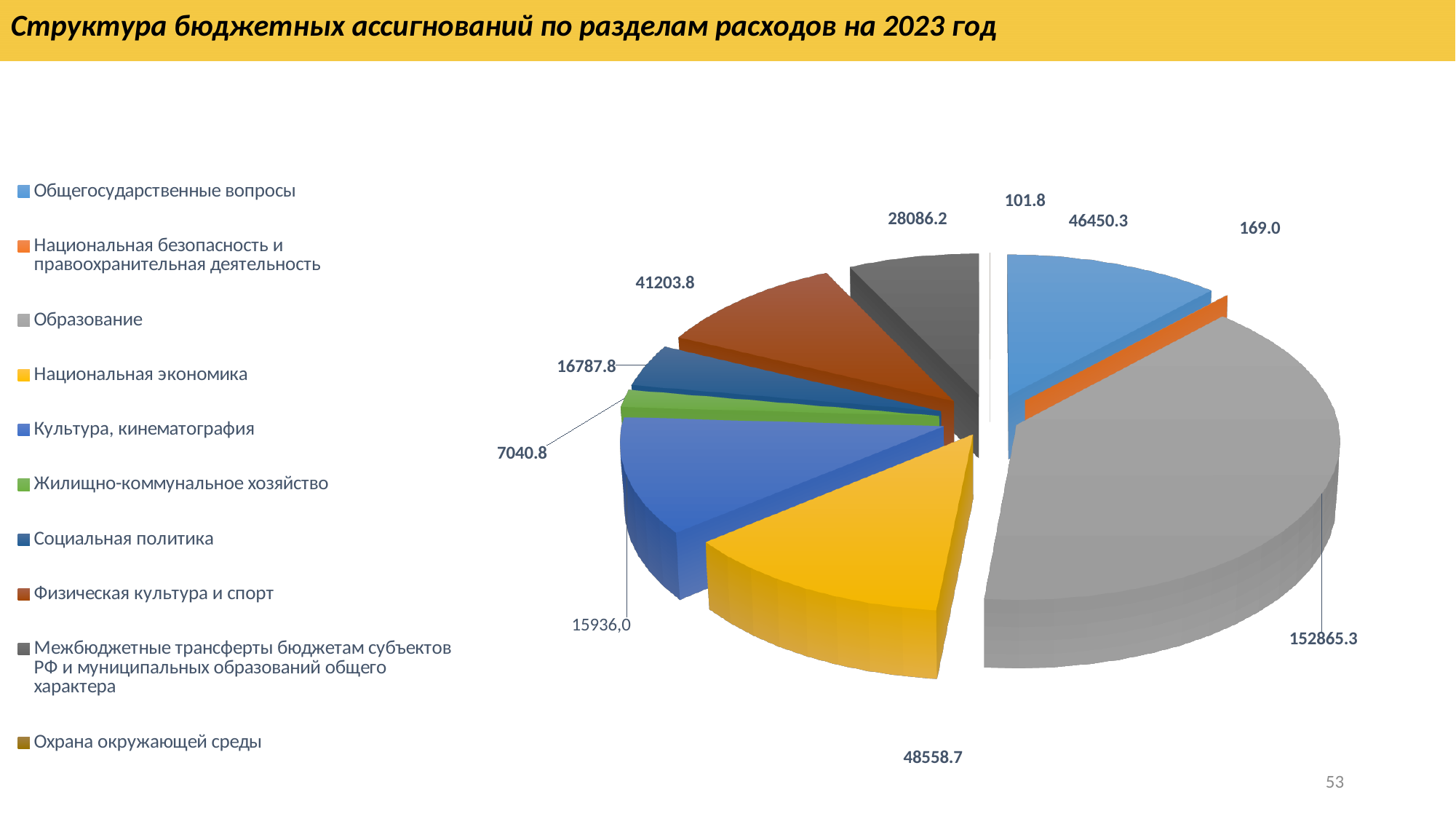
What kind of chart is shown on the slide? pie chart Which category has the smallest value in the pie chart? Охрана окружающей среды What is the value for Межбюджетные трансферты бюджетам субъектов РФ и муниципальных образований общего характера? 28086.2 What is the value for Жилищно-коммунальное хозяйство? 7040.8 Which category has the largest slice of the pie? Образование What is the value for Физическая культура и спорт? 41203.8 What is the title of the slide's chart? Структура бюджетных ассигнований по разделам расходов на 2023 год Which is larger: Общегосударственные вопросы or Национальная экономика? Национальная экономика How many categories does the legend of the pie chart list? 10 What is the value for Образование? 152865.3 What is the difference between the values for Социальная политика and Культура, кинематография? 851.8 What is the value for Национальная экономика? 48558.7